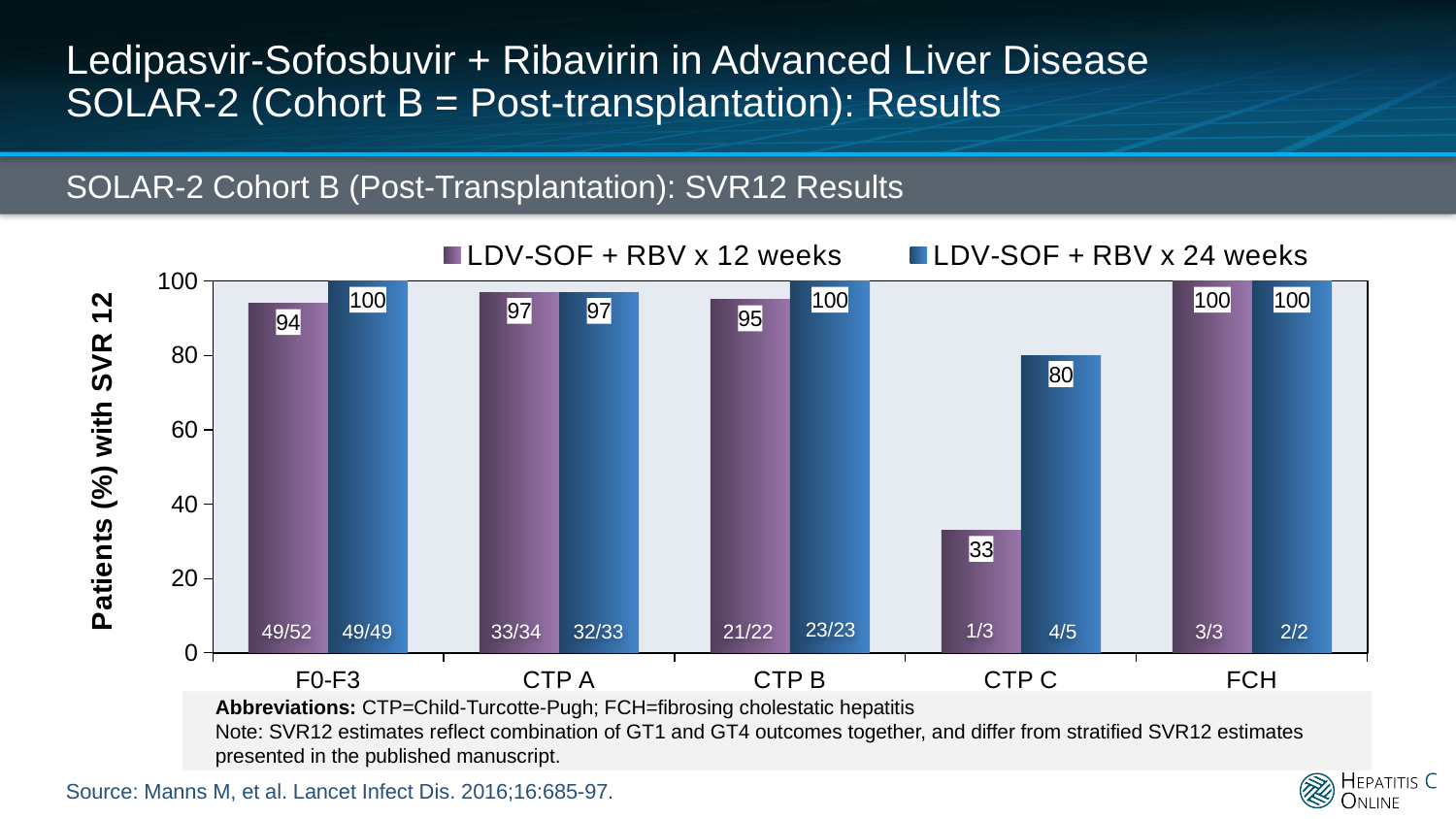
What kind of chart is shown on the slide? Bar chart What is the difference between the 24-week and 12-week SVR12 rates in the CTP C group? 47 What is the SVR12 rate for the LDV-SOF + RBV x 12 weeks series in the F0-F3 group? 94 What is the patient fraction shown for the LDV-SOF + RBV x 24 weeks bar in the CTP A group? 32/33 What is the SVR12 rate for the LDV-SOF + RBV x 12 weeks series in the CTP C group? 33 In the CTP B group, which series has the higher SVR12 rate, 12 weeks or 24 weeks? LDV-SOF + RBV x 24 weeks Which category has the lowest SVR12 rate for the LDV-SOF + RBV x 12 weeks series? CTP C What is the SVR12 rate for the LDV-SOF + RBV x 24 weeks series in the CTP B group? 100 What is the SVR12 rate for the LDV-SOF + RBV x 24 weeks series in the CTP C group? 80 What is the label of the y axis? Patients (%) with SVR 12 How many categories are shown on the x axis? 5 How many series does the legend list? 2